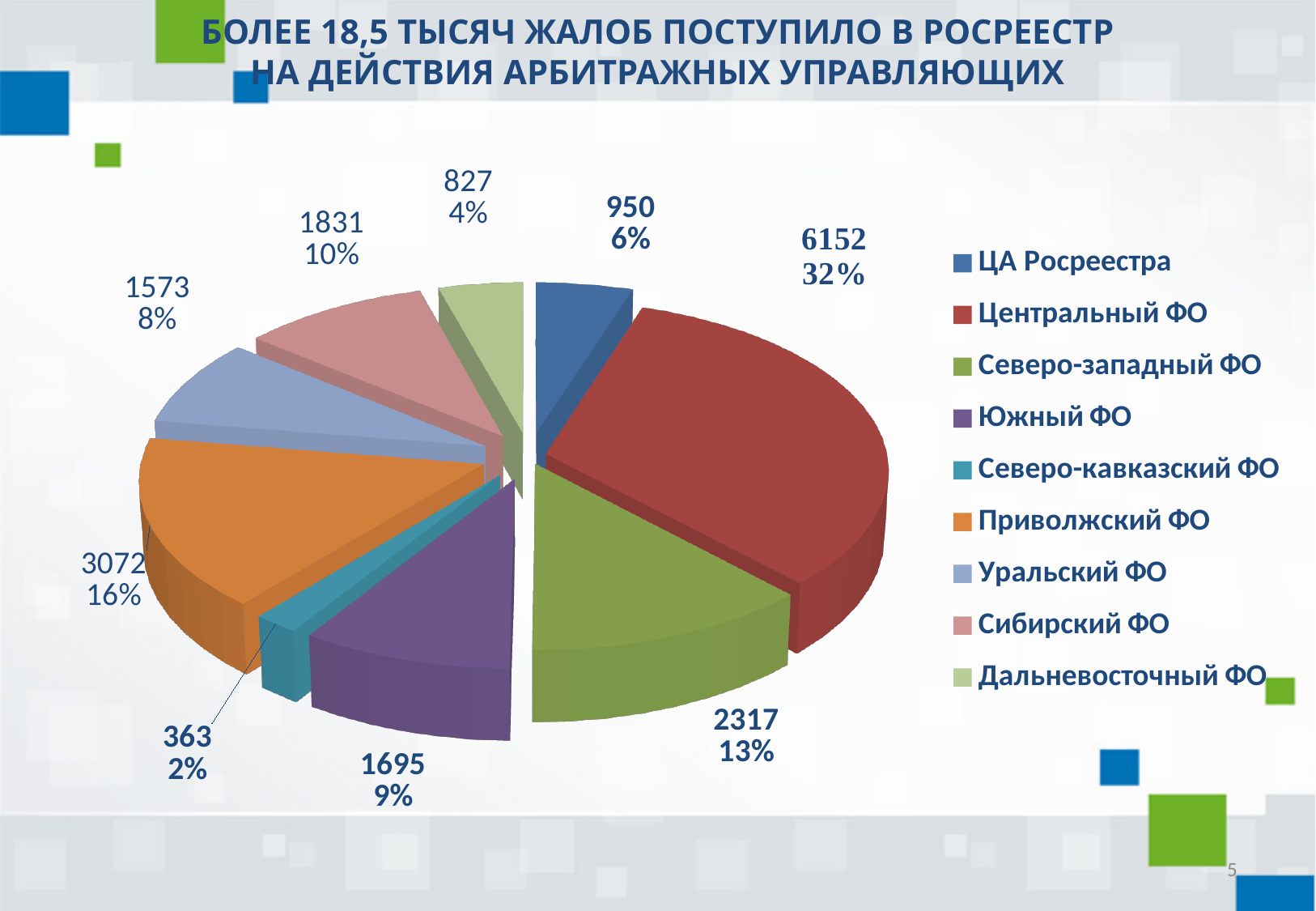
How many slices does the pie chart have? 9 Which category has the smallest slice of the pie? Северо-кавказский ФО What share of the pie does Приволжский ФО have? 16% Which legend entry is shown in red? Центральный ФО What kind of chart is shown on the slide? pie chart What value is shown for Северо-кавказский ФО? 363 What value is shown for Центральный ФО? 6152 What is the difference between the values for Центральный ФО and Приволжский ФО? 3080 What value is shown for Южный ФО? 1695 Which category has the largest slice of the pie? Центральный ФО What share of the pie does Дальневосточный ФО have? 4% Which is larger, the value for Сибирский ФО or the value for Уральский ФО? Сибирский ФО